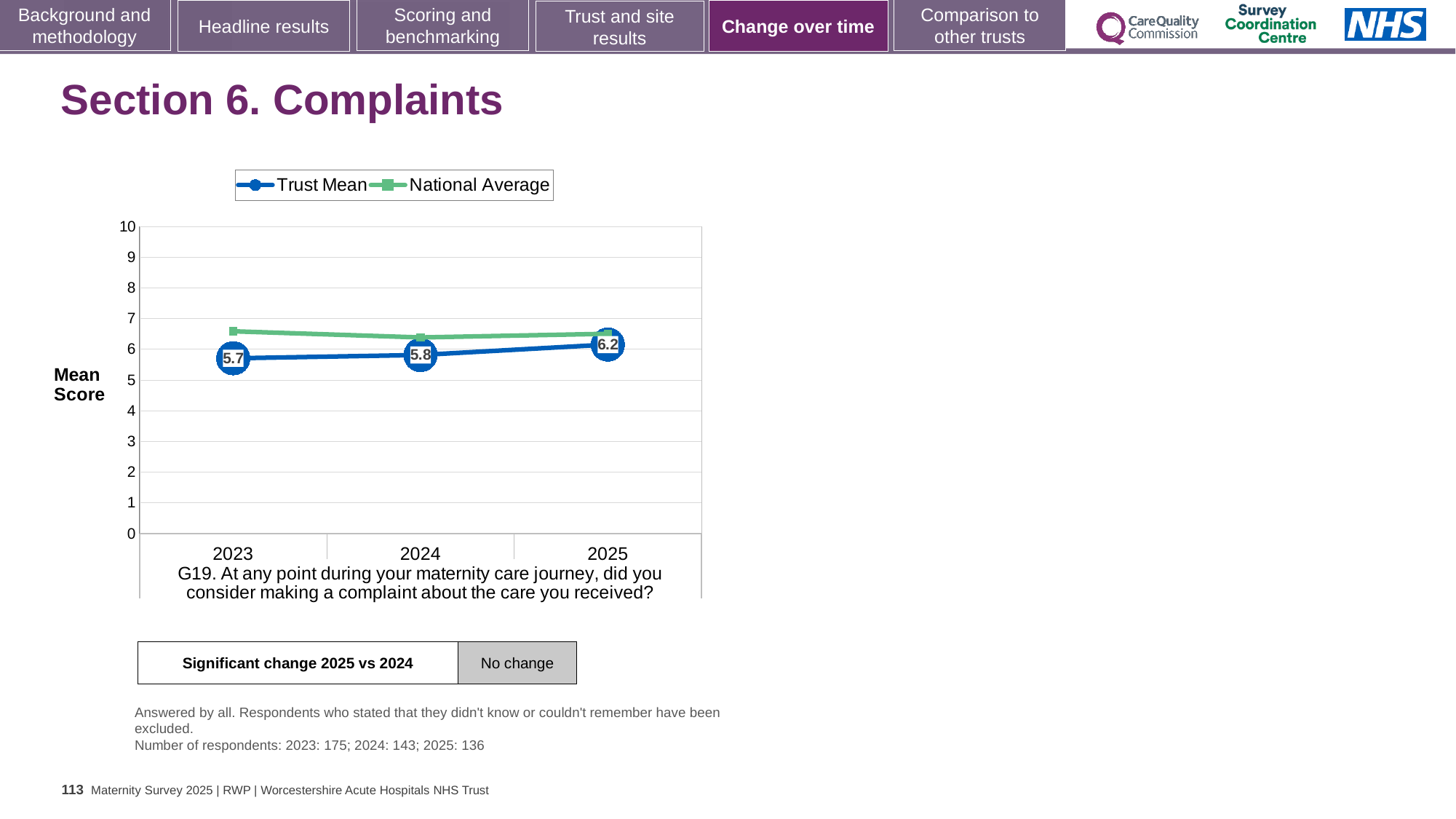
How many years are plotted on the x axis? 3 In 2023, which is higher: the Trust Mean or the National Average? National Average What is the Trust Mean score for 2025? 6.2 What is the Trust Mean score for 2024? 5.8 What kind of chart is shown on the slide? Line chart How many series does the legend list? 2 Is the National Average value for 2023 greater or less than 6? greater What is the difference between the Trust Mean score in 2025 and in 2023? 0.5 Is the National Average value for 2024 greater or less than 7? less In which year is the Trust Mean score lowest? 2023 What is the Trust Mean score for 2023? 5.7 In which year is the Trust Mean score highest? 2025